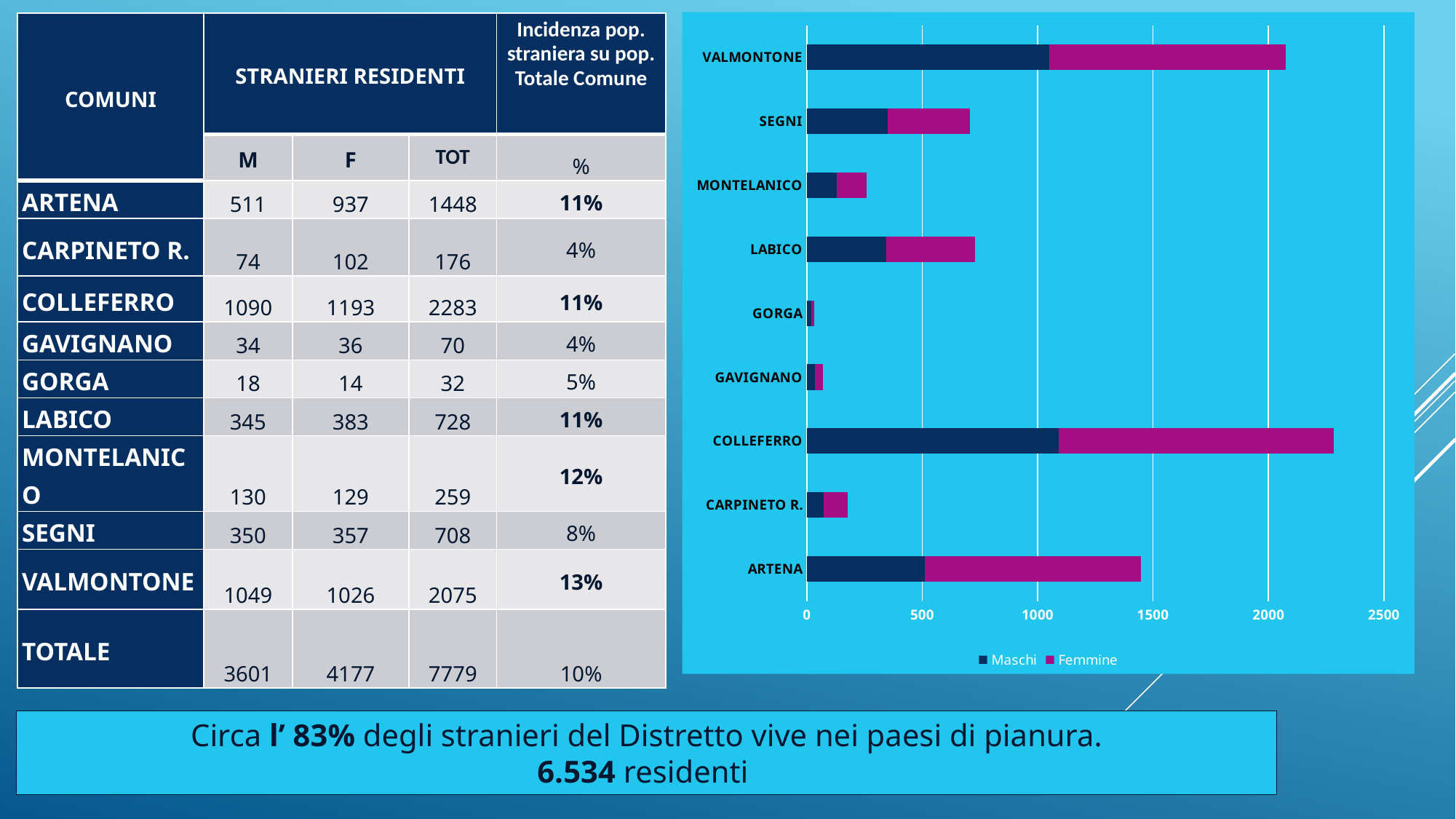
Which comune has the shortest total bar in the chart? GORGA Which has the longer total bar, MONTELANICO or CARPINETO R.? MONTELANICO Which series is shown in magenta in the chart? Femmine How many comuni (categories) are plotted in the bar chart? 9 Is the total bar for ARTENA greater or less than 1000? greater Which has the longer total bar, ARTENA or SEGNI? ARTENA Is the total bar for MONTELANICO greater or less than 500? less Which comune has the longest total bar in the chart? COLLEFERRO Is the total bar for COLLEFERRO greater or less than 2000? greater How many series does the chart legend list? 2 What kind of chart is shown on the right of the slide? stacked bar chart